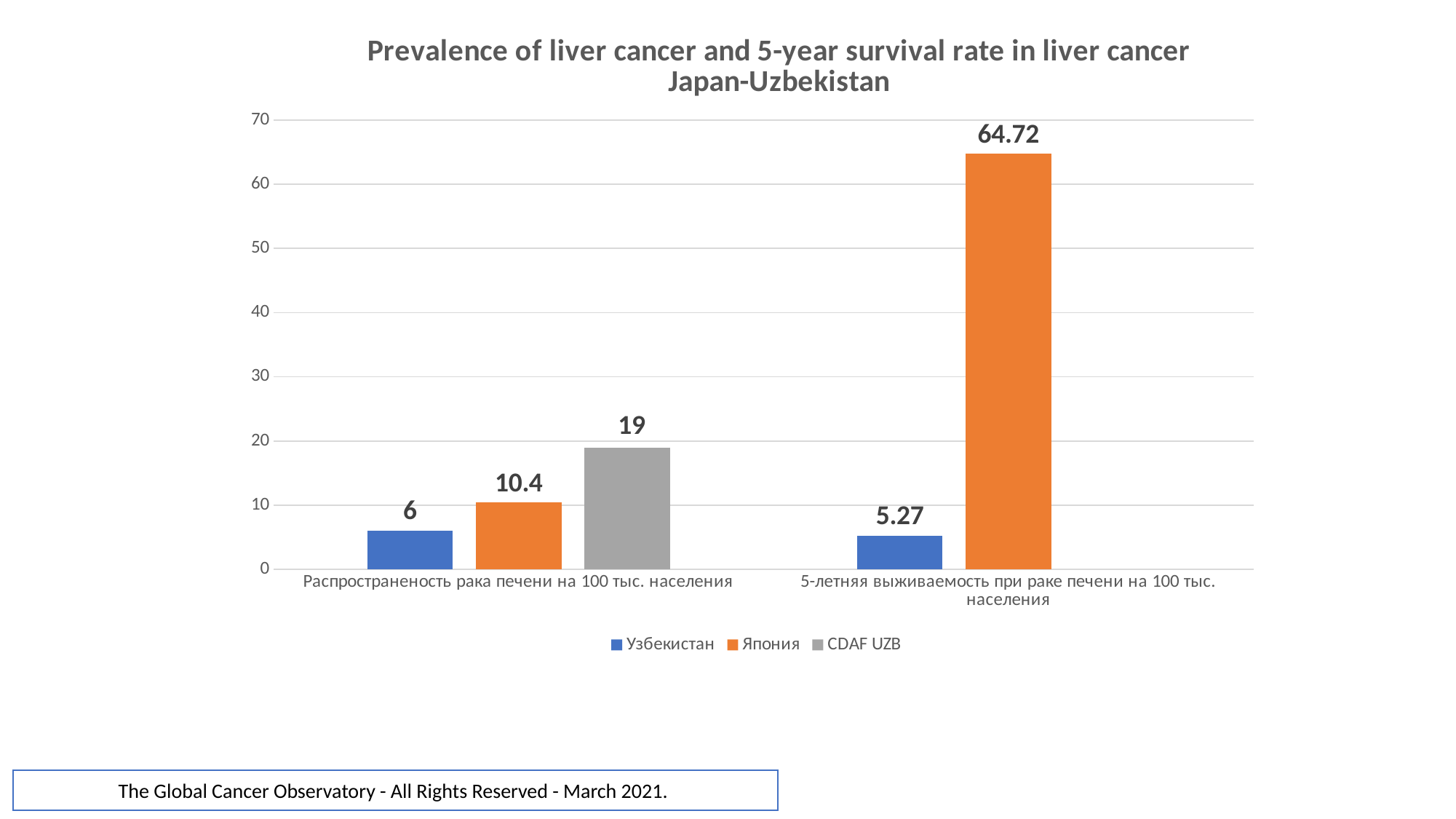
What is the difference between the CDAF UZB and Япония values in the category 'Распространеность рака печени на 100 тыс. населения'? 8.6 What kind of chart is shown on the slide? Bar chart What is the value for CDAF UZB in the category 'Распространеность рака печени на 100 тыс. населения'? 19 What is the value for Узбекистан in the category 'Распространеность рака печени на 100 тыс. населения'? 6 How many series does the legend list? 3 What colour represents Япония in the chart? Orange Which series has the lowest value in the category '5-летняя выживаемость при раке печени на 100 тыс. населения'? Узбекистан What is the difference between the Япония and Узбекистан values in the category '5-летняя выживаемость при раке печени на 100 тыс. населения'? 59.45 Which is larger: the Япония value for 'Распространеность рака печени на 100 тыс. населения' or the Япония value for '5-летняя выживаемость при раке печени на 100 тыс. населения'? 5-летняя выживаемость при раке печени на 100 тыс. населения Which series has the highest value in the category 'Распространеность рака печени на 100 тыс. населения'? CDAF UZB What is the value for Узбекистан in the category '5-летняя выживаемость при раке печени на 100 тыс. населения'? 5.27 What is the value for Япония in the category '5-летняя выживаемость при раке печени на 100 тыс. населения'? 64.72